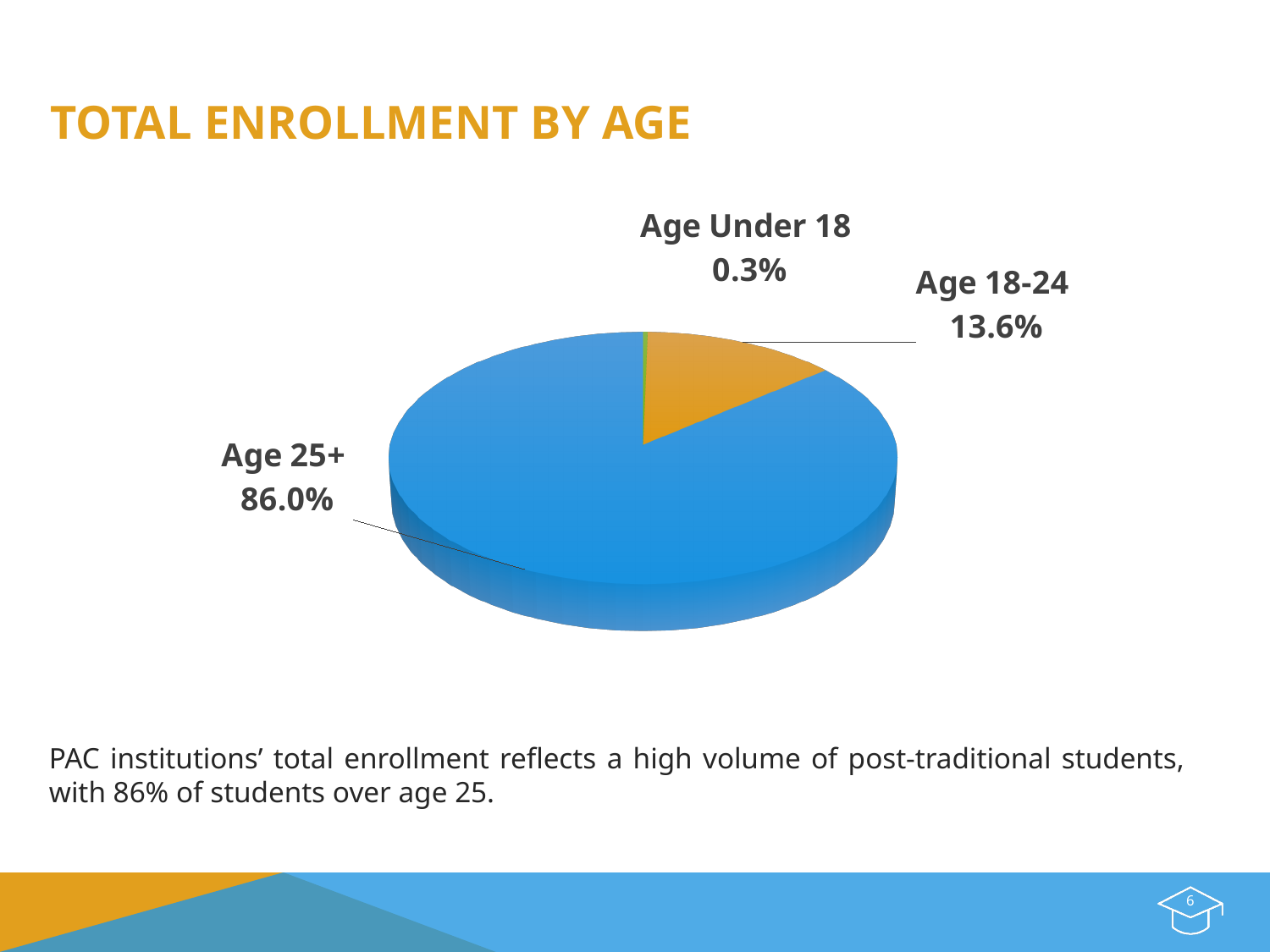
What share of total enrollment is Age 18-24? 13.6% Which is larger, the share for Age 18-24 or the share for Age Under 18? Age 18-24 What share of total enrollment is Age 25+? 86.0% What share of total enrollment is Age Under 18? 0.3% What is the difference in percentage points between Age 18-24 and Age Under 18? 13.3 Which age group has the largest share of enrollment? Age 25+ What is the difference in percentage points between Age 25+ and Age 18-24? 72.4 What colour is the Age 25+ slice of the pie chart? Blue What is the title of the slide containing the pie chart? TOTAL ENROLLMENT BY AGE How many age groups are shown in the pie chart? 3 Which age group has the smallest share of enrollment? Age Under 18 What kind of chart is shown on the slide? Pie chart